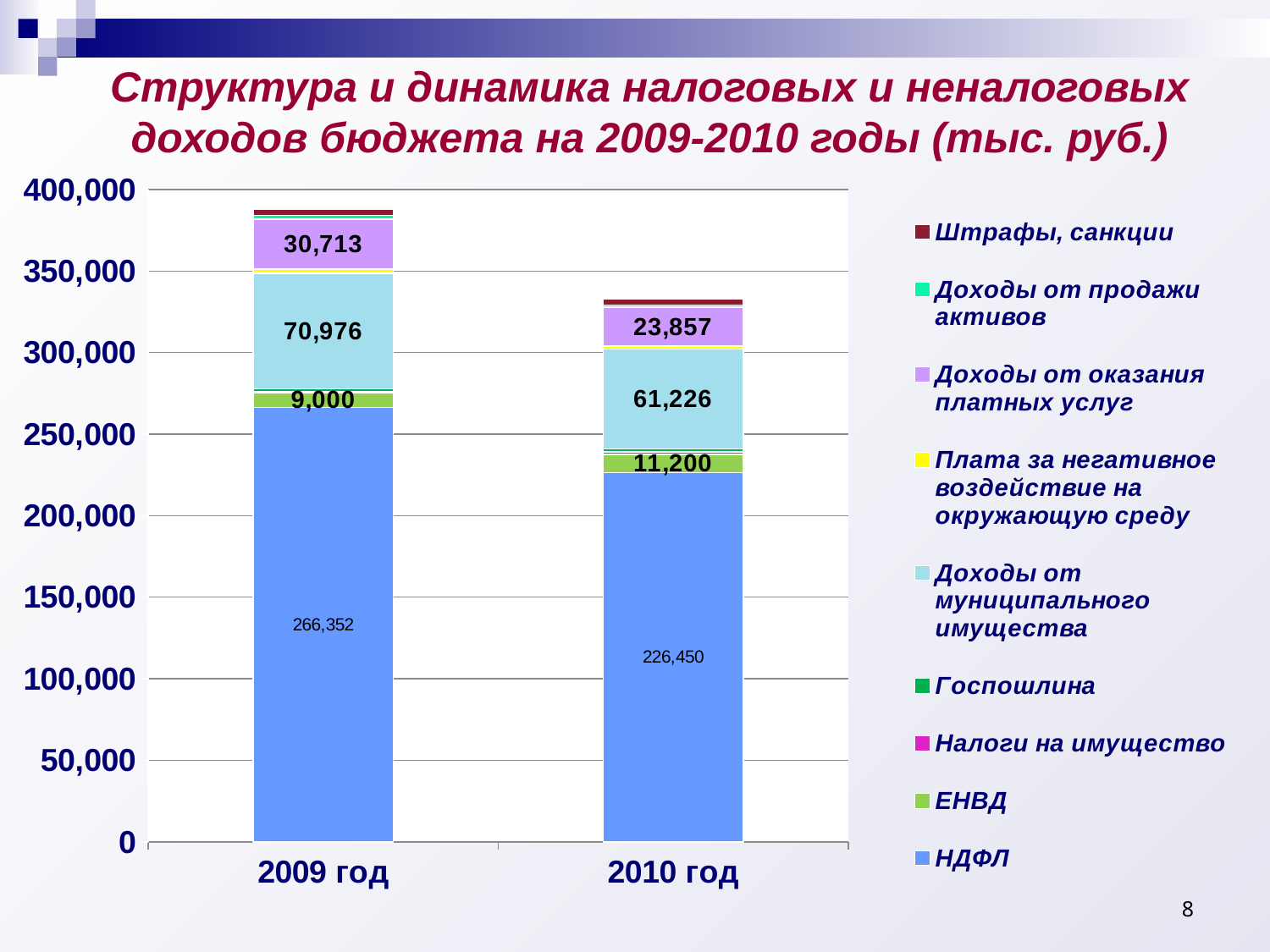
How many series does the legend list? 9 What is the value of НДФЛ for 2009 год? 266,352 By how much did НДФЛ decrease from 2009 год to 2010 год? 39,902 Which year has the larger value for Доходы от муниципального имущества, 2009 год or 2010 год? 2009 год What is the value of Доходы от муниципального имущества for 2009 год? 70,976 What is the value of Доходы от оказания платных услуг for 2010 год? 23,857 Is the total height of the 2010 год bar greater or less than 350,000? less What is the value of ЕНВД for 2010 год? 11,200 What is the difference between ЕНВД in 2010 год and 2009 год? 2,200 What is the value of НДФЛ for 2010 год? 226,450 How many categories (years) are shown on the x axis? 2 What kind of chart is shown on the slide? Stacked bar chart